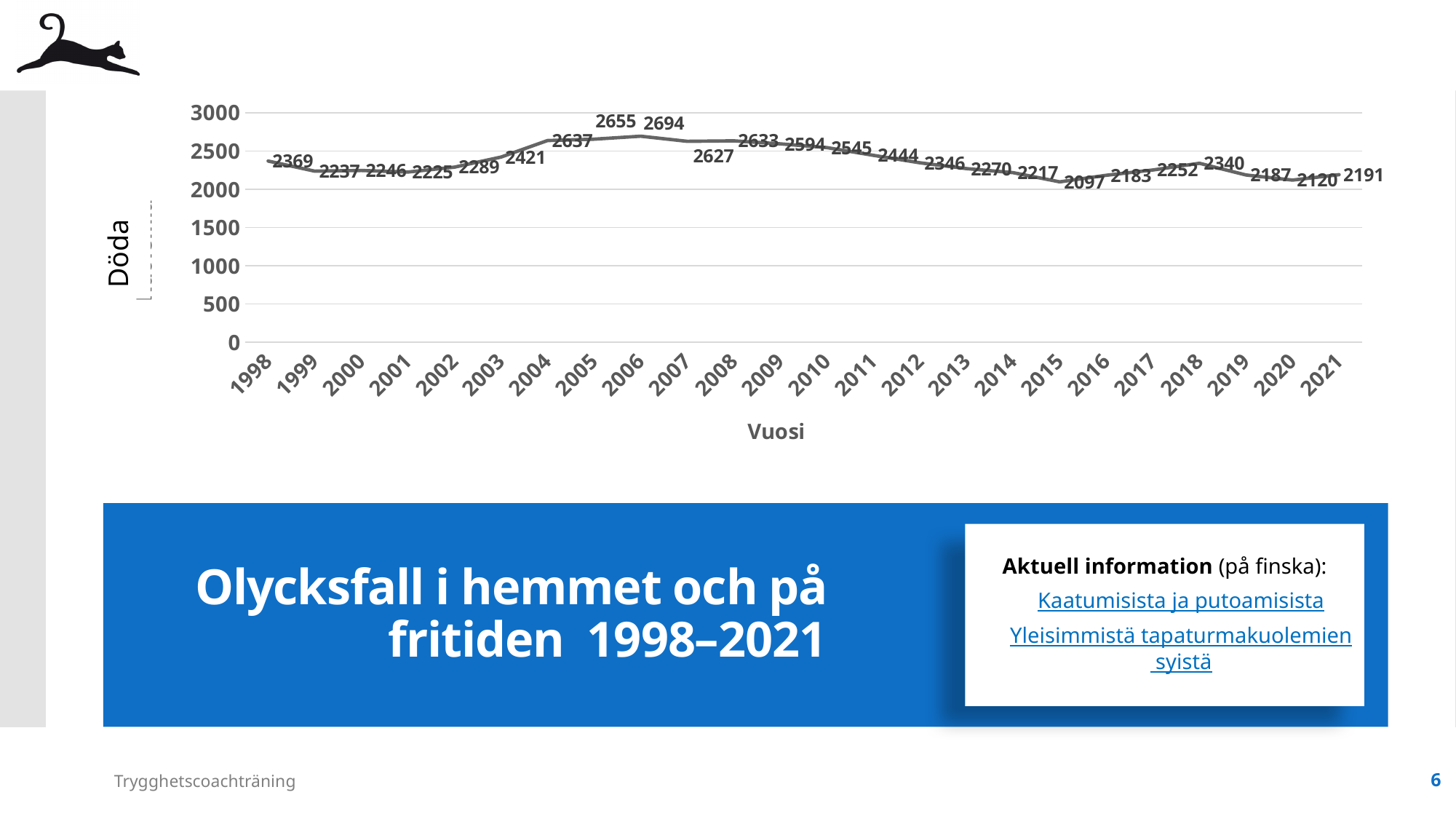
What is the value for 1998? 2369 Is the value for 2010 greater or less than 2500? greater What is the value for 2006? 2694 What is the value for 2021? 2191 Which year has the lowest value? 2015 What is the value for 2015? 2097 What is the label of the x axis? Vuosi What kind of chart is shown? line chart Which is larger, the value for 2004 or the value for 2018? 2004 Which year has the highest value? 2006 What is the difference between the values for 2006 and 2015? 597 How many years are plotted on the x axis? 24